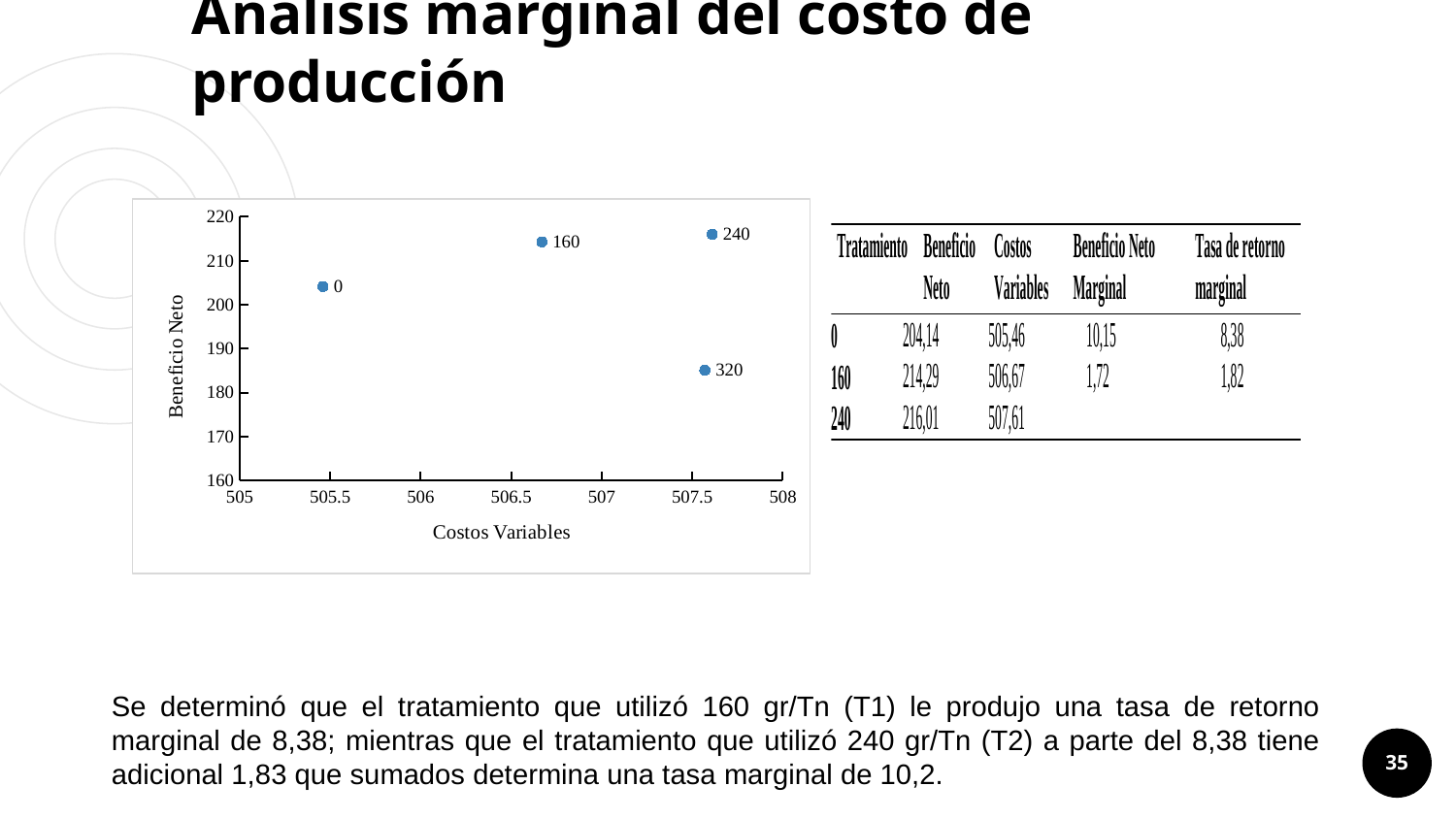
How many data points are plotted in the chart? 4 Is the Beneficio Neto for treatment 160 greater or less than 210? greater Is the Beneficio Neto for treatment 320 greater or less than 190? less Which treatment point has the lowest Costos Variables in the chart? 0 What is the title of the vertical axis of the chart? Beneficio Neto According to the table on the slide, what is the Beneficio Neto for treatment 240? 216,01 Are the Costos Variables for treatment 240 greater or less than 507? greater Which has the higher Beneficio Neto, treatment 160 or treatment 320? 160 What kind of chart is shown on the slide? scatter chart What is the title of the horizontal axis of the chart? Costos Variables Which treatment point has the lowest Beneficio Neto in the chart? 320